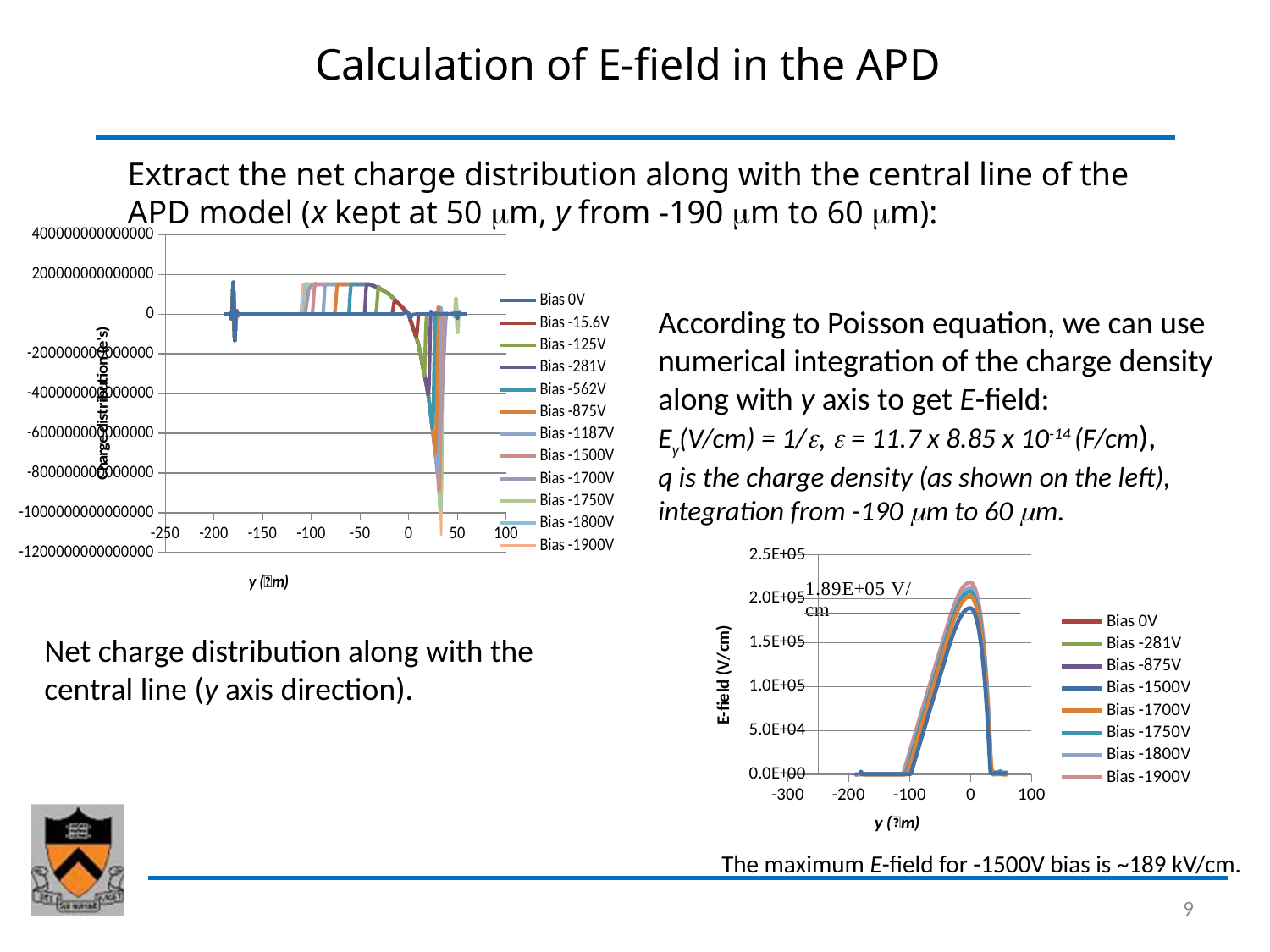
What kind of chart is the right chart showing the E-field? line chart On the right chart, what is the y-axis label? E-field (V/cm) What is the first legend entry of the left chart? Bias 0V What kind of chart is the left chart showing the net charge distribution? line chart On the right chart, does the E-field rise or fall as y goes from -100 μm to 0 μm? rise On the right chart, is the peak E-field for Bias -1500V greater or less than 2.0E+05? less How many series does the legend of the left chart (net charge distribution) list? 12 How many series does the legend of the right chart (E-field) list? 8 On the right chart, what value is annotated at the horizontal reference line near the peak? 1.89E+05 V/cm On the right chart, which series reaches a higher peak E-field, Bias -1900V or Bias -1500V? Bias -1900V On the left chart, is the lowest value of the charge distribution greater or less than -600000000000000? less